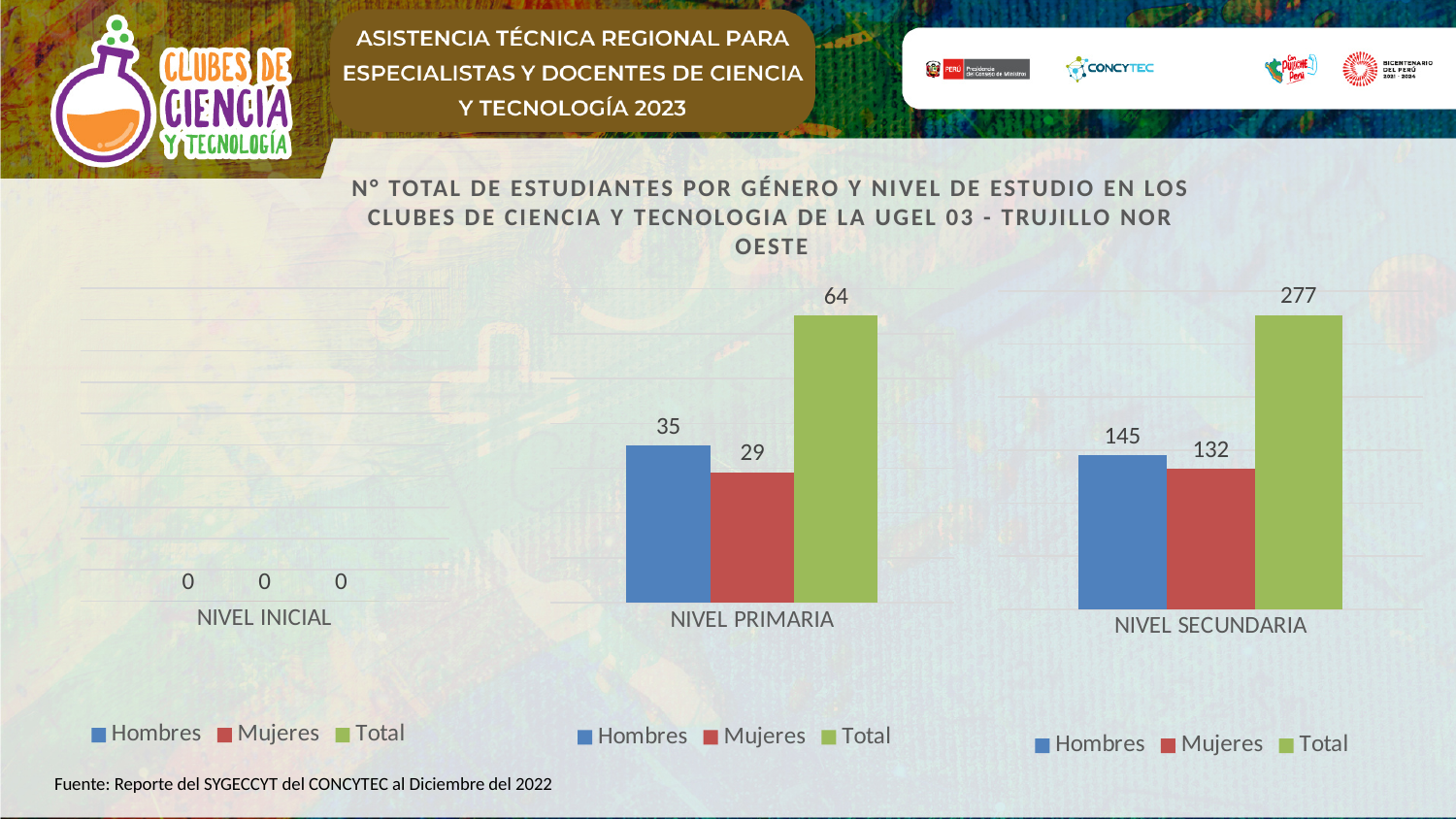
In the NIVEL PRIMARIA chart, which is larger, Hombres or Mujeres? Hombres In the NIVEL SECUNDARIA chart, what is the difference between Hombres and Mujeres? 13 In the NIVEL SECUNDARIA chart, which series has the highest value? Total In the NIVEL PRIMARIA chart, which series has the lowest value? Mujeres What kind of chart is the NIVEL PRIMARIA chart? Bar chart How many series does the legend of the NIVEL SECUNDARIA chart list? 3 In the NIVEL INICIAL chart, what is the value for Hombres? 0 In the NIVEL PRIMARIA chart, what is the value for Mujeres? 29 In the NIVEL SECUNDARIA chart, what is the value for Mujeres? 132 In the NIVEL PRIMARIA chart, what is the value for Hombres? 35 In the NIVEL SECUNDARIA chart, what is the value for Total? 277 What colour represents the Total series in the charts? Green